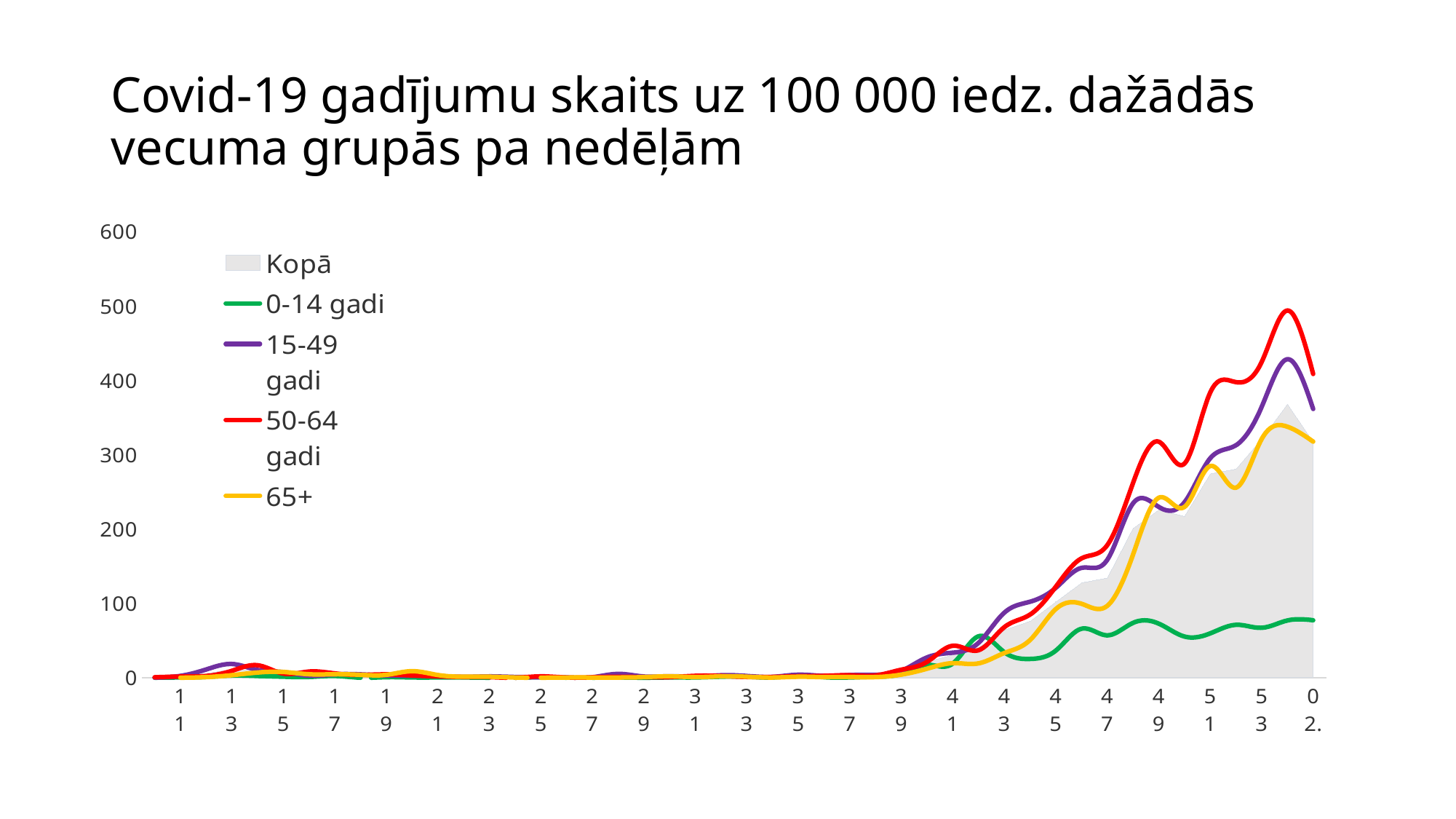
Is the peak value for 15-49 gadi greater or less than 400? greater What is the title of the chart? Covid-19 gadījumu skaits uz 100 000 iedz. dažādās vecuma grupās pa nedēļām What kind of chart is shown on the slide? combination area and line chart Which series is drawn as a shaded grey area rather than a line? Kopā Which age group has the lowest value at the last week shown (02.)? 0-14 gadi Is the peak value for 50-64 gadi greater or less than 400? greater Is the value for 0-14 gadi at week 53 greater or less than 100? less Which age group reaches the highest value on the chart? 50-64 gadi Do the values generally rise or fall from week 11 to the end of the x axis? rise At the last week shown (02.), which is larger: the value for 50-64 gadi or the value for 0-14 gadi? 50-64 gadi How many series does the legend list? 5